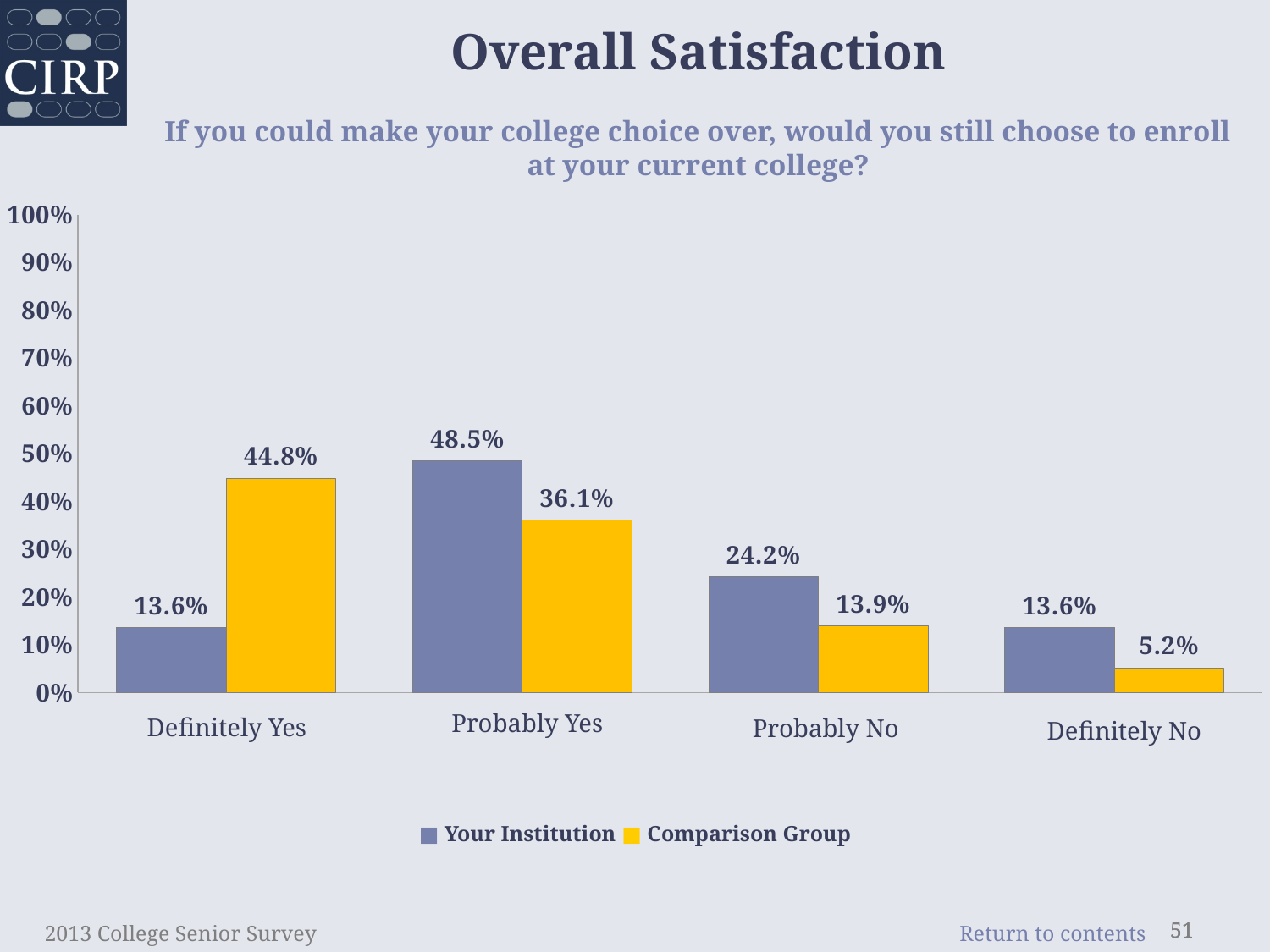
What is the value for Your Institution in the Probably No category? 24.2% Which category has the highest value for Your Institution? Probably Yes In the Definitely Yes category, which is larger: Your Institution or Comparison Group? Comparison Group Is the value for Comparison Group in the Probably No category greater or less than 20%? less How many series does the legend list? 2 What is the value for Comparison Group in the Definitely Yes category? 44.8% What kind of chart is shown on the slide? Bar chart What is the value for Comparison Group in the Definitely No category? 5.2% Which category has the lowest value for Comparison Group? Definitely No How many categories are shown on the x axis? 4 What is the difference between Your Institution and Comparison Group in the Probably Yes category? 12.4% What is the value for Your Institution in the Definitely Yes category? 13.6%